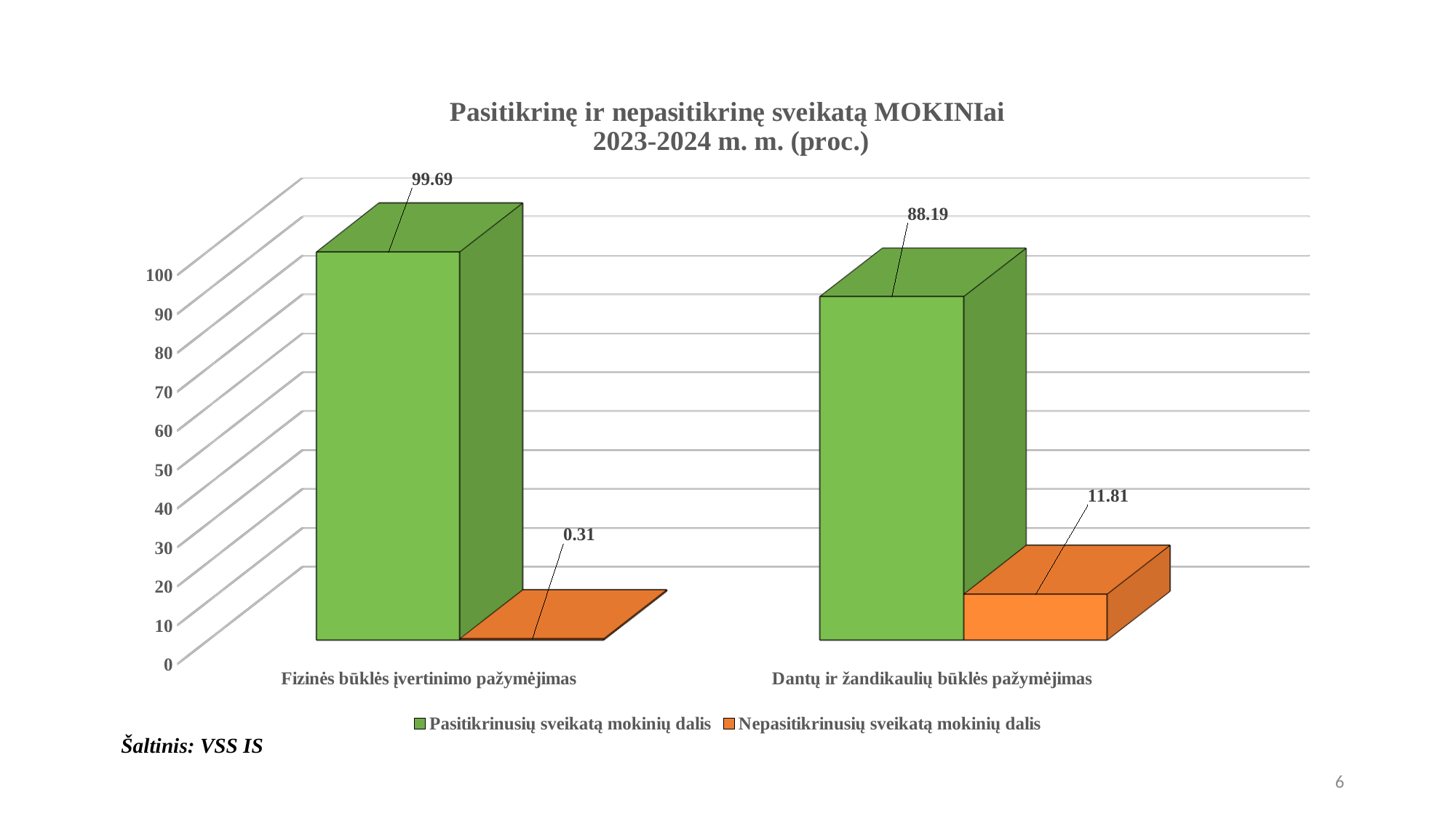
What is the value of 'Nepasitikrinusių sveikatą mokinių dalis' for 'Fizinės būklės įvertinimo pažymėjimas'? 0.31 What is the difference between the 'Pasitikrinusių sveikatą mokinių dalis' values for the two categories? 11.50 What kind of chart is shown on the slide? bar chart How many series does the legend list? 2 Which category has the higher value for 'Pasitikrinusių sveikatą mokinių dalis'? Fizinės būklės įvertinimo pažymėjimas Which category has the lowest value for 'Nepasitikrinusių sveikatą mokinių dalis'? Fizinės būklės įvertinimo pažymėjimas What is the value of 'Nepasitikrinusių sveikatą mokinių dalis' for 'Dantų ir žandikaulių būklės pažymėjimas'? 11.81 What is the value of 'Pasitikrinusių sveikatą mokinių dalis' for 'Dantų ir žandikaulių būklės pažymėjimas'? 88.19 How many categories are shown on the x axis? 2 Is the 'Nepasitikrinusių sveikatą mokinių dalis' value for 'Dantų ir žandikaulių būklės pažymėjimas' larger or smaller than the 'Nepasitikrinusių sveikatą mokinių dalis' value for 'Fizinės būklės įvertinimo pažymėjimas'? larger What is the value of 'Pasitikrinusių sveikatą mokinių dalis' for 'Fizinės būklės įvertinimo pažymėjimas'? 99.69 What is the difference between the 'Nepasitikrinusių sveikatą mokinių dalis' values for 'Dantų ir žandikaulių būklės pažymėjimas' and 'Fizinės būklės įvertinimo pažymėjimas'? 11.50